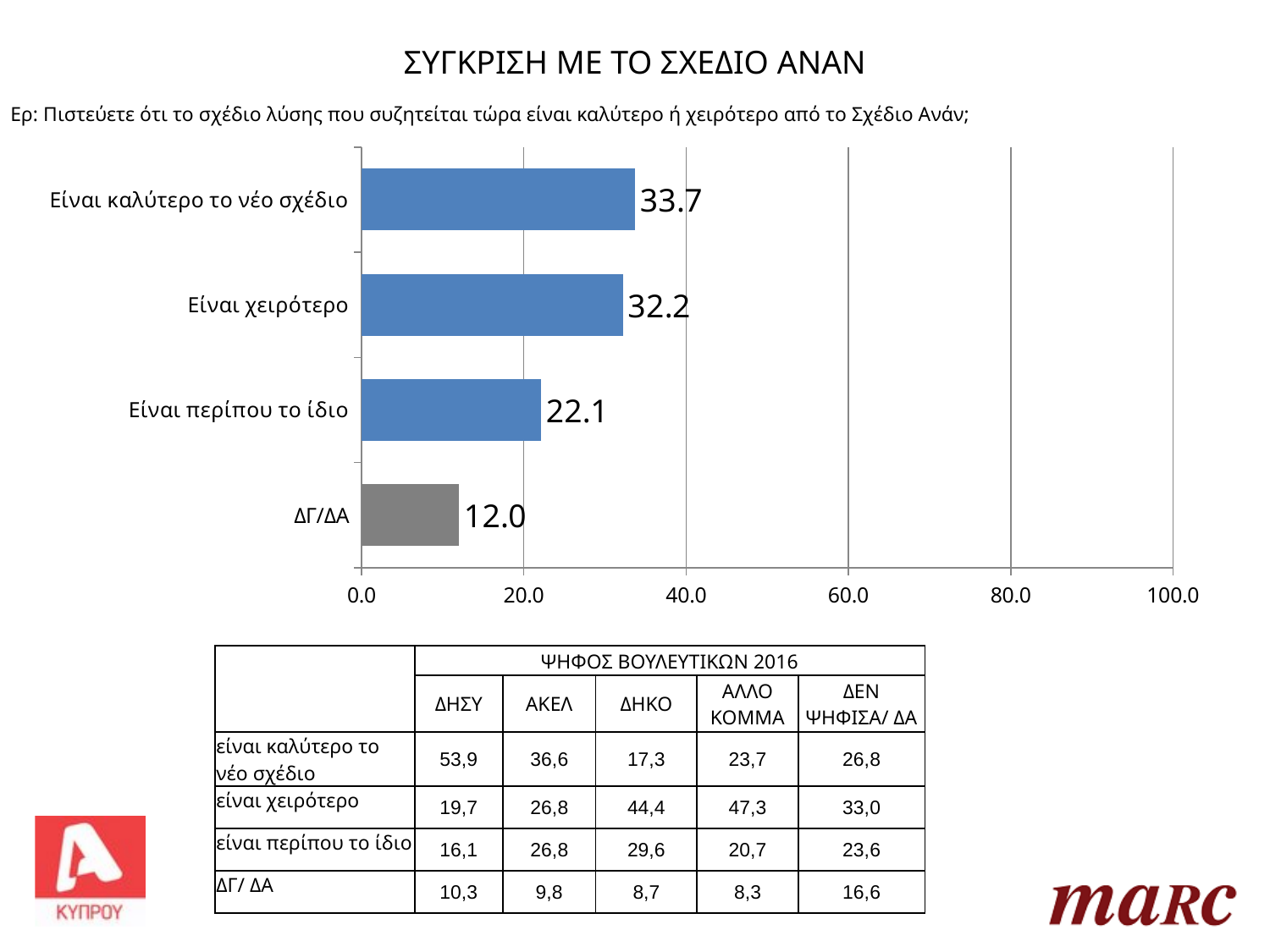
What value is shown for "Είναι καλύτερο το νέο σχέδιο"? 33.7 Is the value for "Είναι καλύτερο το νέο σχέδιο" greater or less than 40.0? less Which is larger: the value for "Είναι χειρότερο" or the value for "Είναι περίπου το ίδιο"? Είναι χειρότερο What value is shown for "Είναι χειρότερο"? 32.2 What is the difference between the values for "Είναι καλύτερο το νέο σχέδιο" and "Είναι χειρότερο"? 1.5 What value is shown for "Είναι περίπου το ίδιο"? 22.1 What value is shown for "ΔΓ/ΔΑ"? 12.0 How many categories are shown in the chart? 4 What is the difference between the values for "Είναι περίπου το ίδιο" and "ΔΓ/ΔΑ"? 10.1 What type of chart is shown on the slide? bar chart Which category has the lowest value in the chart? ΔΓ/ΔΑ Which category has the highest value in the chart? Είναι καλύτερο το νέο σχέδιο